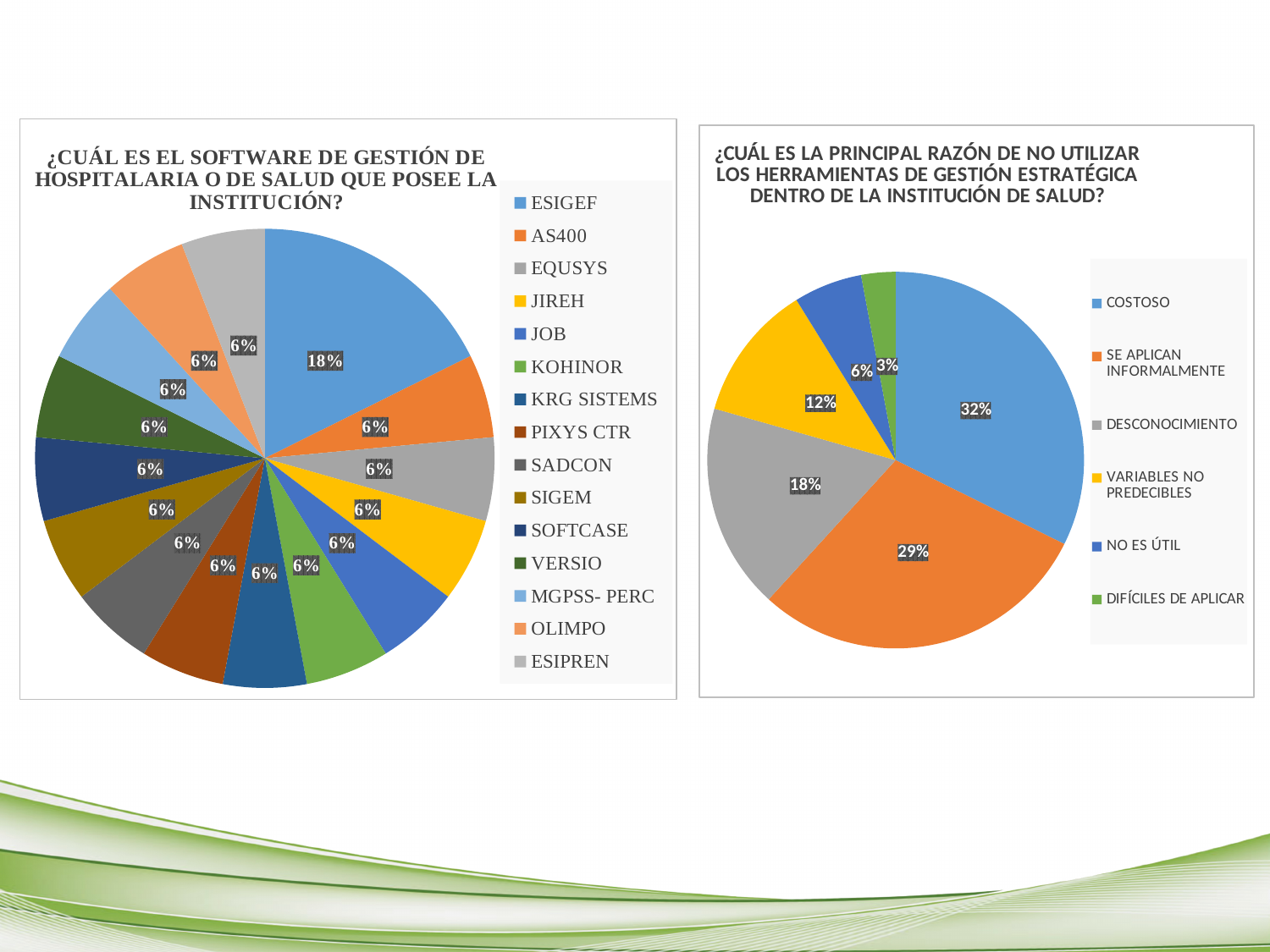
How many categories does the legend of the left pie chart about hospital management software list? 15 In the right pie chart about the main reason for not using strategic management tools, which reason has the smallest share? DIFÍCILES DE APLICAR In the right pie chart about the main reason for not using strategic management tools, what share does SE APLICAN INFORMALMENTE have? 29% In the right pie chart about the main reason for not using strategic management tools, what share does COSTOSO have? 32% In the right pie chart about the main reason for not using strategic management tools, which is larger: NO ES ÚTIL or DIFÍCILES DE APLICAR? NO ES ÚTIL In the left pie chart about hospital management software, which software has the largest share? ESIGEF In the left pie chart about hospital management software, what share does ESIGEF have? 18% How many categories does the legend of the right pie chart about the main reason for not using strategic management tools list? 6 What type of chart is used on the left of the slide, titled '¿CUÁL ES EL SOFTWARE DE GESTIÓN DE HOSPITALARIA O DE SALUD QUE POSEE LA INSTITUCIÓN?'? Pie chart In the left pie chart about hospital management software, what share does AS400 have? 6% In the right pie chart about the main reason for not using strategic management tools, what is the difference between the shares of DESCONOCIMIENTO and VARIABLES NO PREDECIBLES? 6% In the right pie chart about the main reason for not using strategic management tools, which reason has the largest share? COSTOSO